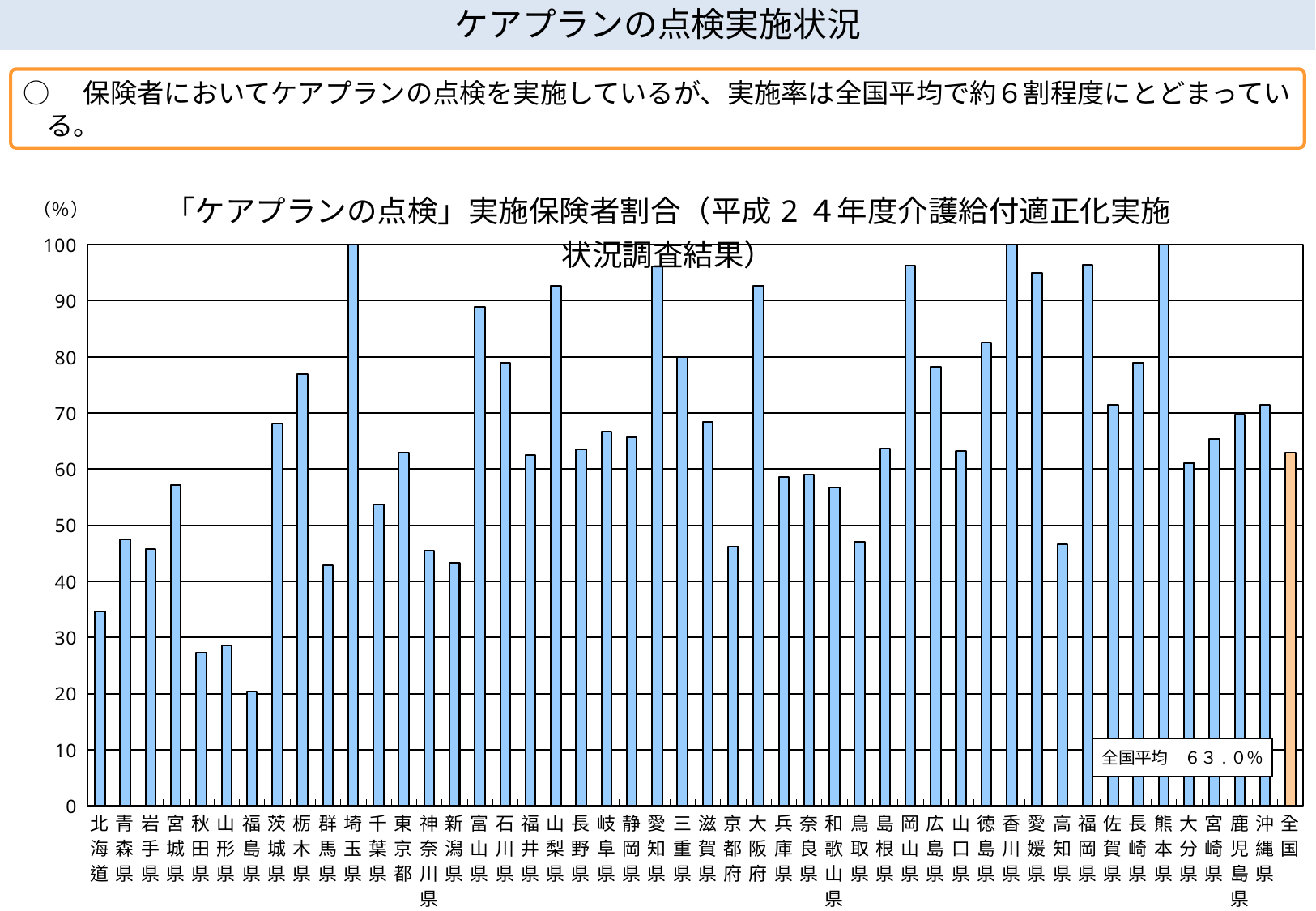
Is the value for 岡山県 greater or less than 90? greater What unit is shown at the top of the vertical axis? (%) How many bars (categories) are plotted in the chart, including 全国? 48 What is the value for 埼玉県? 100 Is the value for 栃木県 greater or less than 70? greater Which is larger, the value for 秋田県 or the value for 宮城県? 宮城県 Which is larger, the value for 埼玉県 or the value for 千葉県? 埼玉県 What is the national average (全国平均) value shown in the chart's text box? 63.0% Is the value for 北海道 greater or less than 40? less Which prefecture has the lowest value in the chart? 福島県 What kind of chart is shown on the slide? bar chart